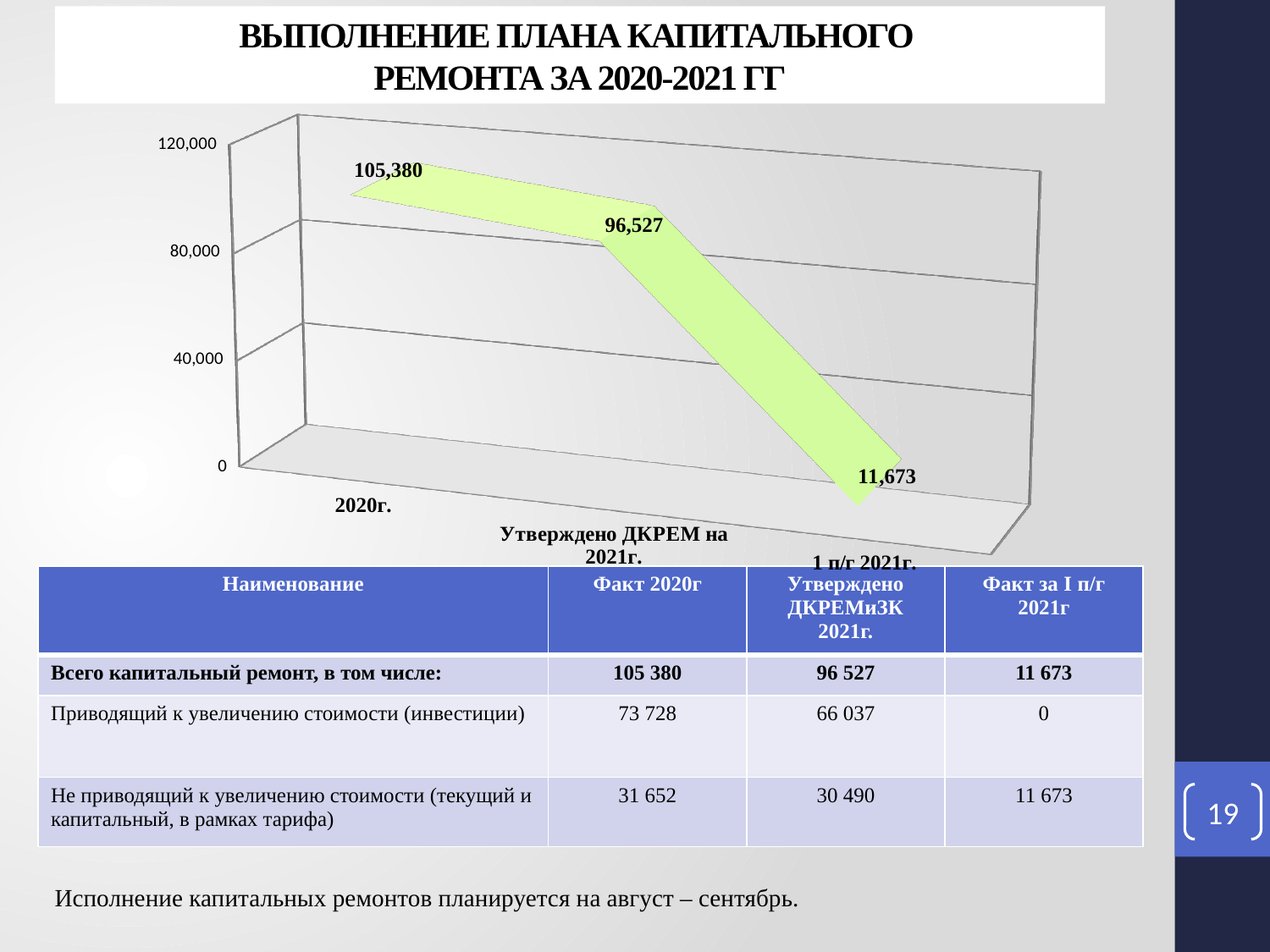
How many categories are plotted along the x axis of the chart? 3 Which is larger, the value for 2020г. or the value for 1 п/г 2021г.? 2020г. Which category has the lowest value in the chart? 1 п/г 2021г. Which category has the highest value in the chart? 2020г. What is the difference between the values for Утверждено ДКРЕМ на 2021г. and 1 п/г 2021г.? 84,854 What is the value plotted for 2020г.? 105,380 Do the plotted values rise or fall from left to right along the x axis? fall What is the title of the slide containing the chart? ВЫПОЛНЕНИЕ ПЛАНА КАПИТАЛЬНОГО РЕМОНТА ЗА 2020-2021 ГГ What is the value plotted for Утверждено ДКРЕМ на 2021г.? 96,527 What is the value plotted for 1 п/г 2021г.? 11,673 Is the value for 1 п/г 2021г. greater or less than 40,000? less What is the difference between the values for 2020г. and Утверждено ДКРЕМ на 2021г.? 8,853